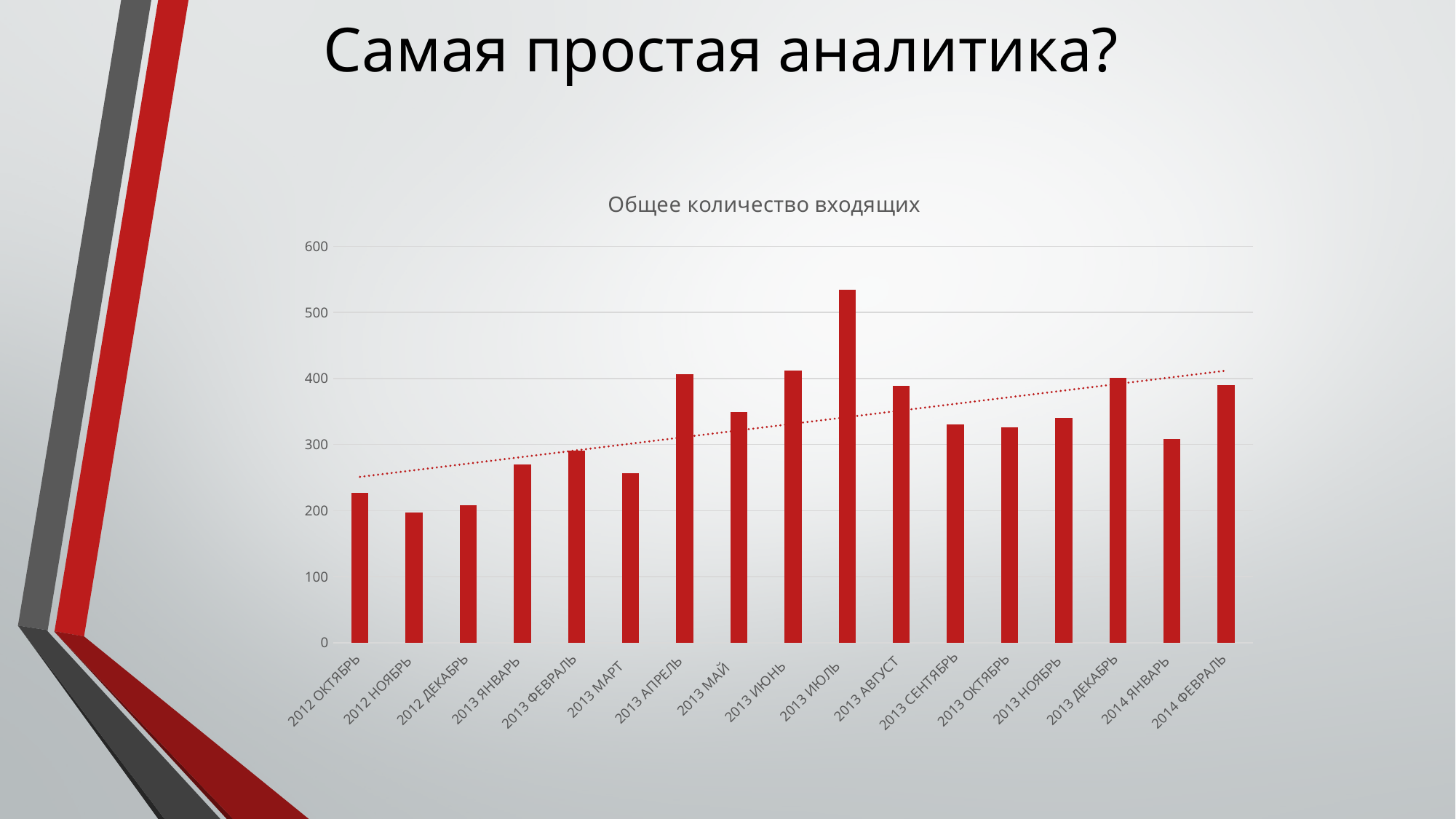
Is the value for 2013 Март greater or less than 300? less Which month has the highest value in the chart? 2013 Июль Is the value for 2012 Октябрь greater or less than 200? greater Is the value for 2013 Май greater or less than 400? less Which is larger, the value for 2013 Июль or the value for 2013 Апрель? 2013 Июль What kind of chart is shown on the slide? Bar chart What is the title of the chart? Общее количество входящих Which is larger, the value for 2012 Ноябрь or the value for 2013 Январь? 2013 Январь According to the dotted trend line, do the values generally rise or fall from 2012 Октябрь to 2014 Февраль? Rise How many months (bars) are plotted in the chart? 17